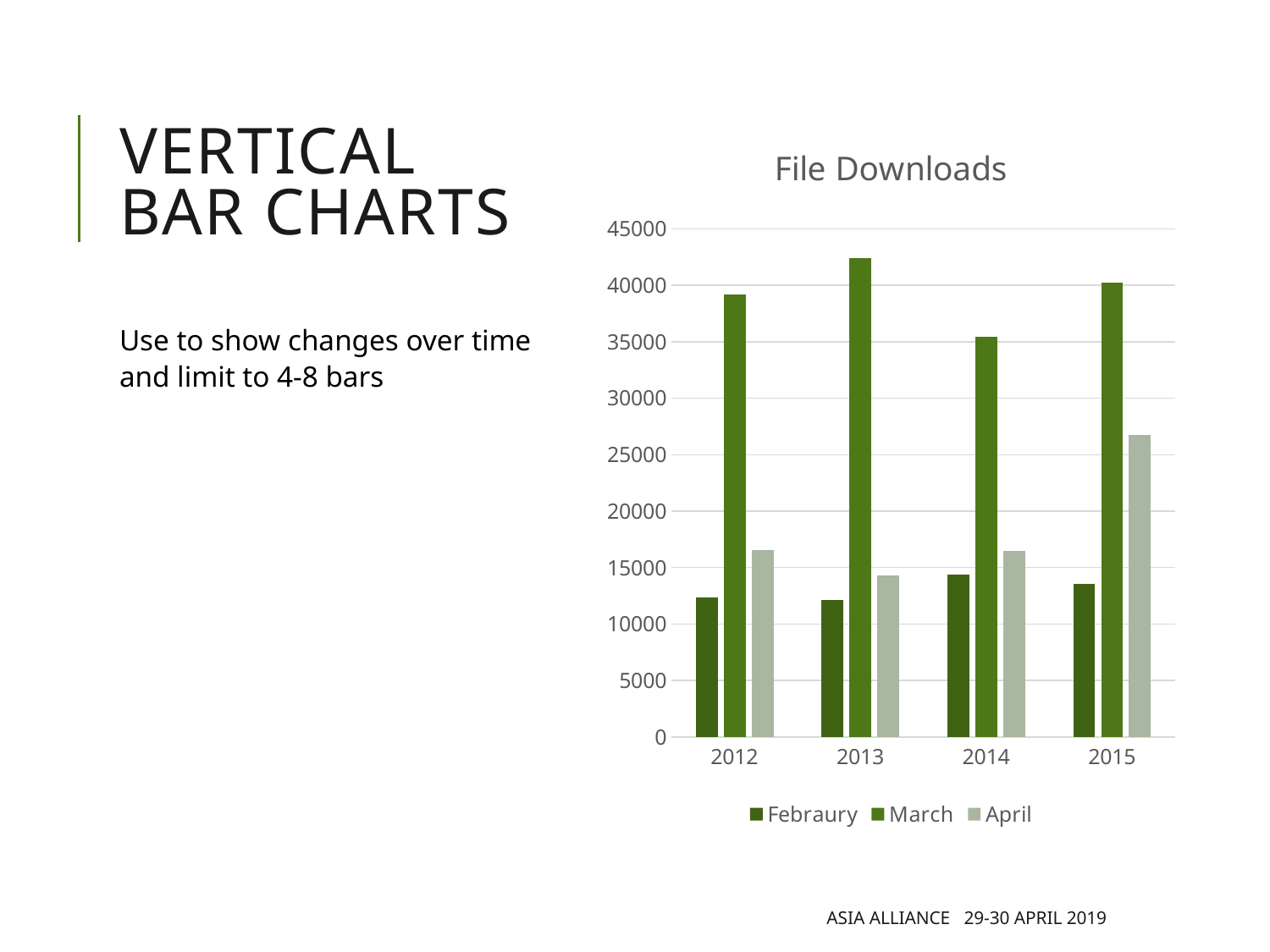
What kind of chart is shown on the slide? bar chart What is the title of the chart? File Downloads In which year is the April value highest? 2015 How many series does the legend list? 3 In which year is the March value lowest? 2014 Is the March value for 2013 greater or less than 40000? greater Is the April value for 2015 greater or less than 25000? greater Which series is shown in the lightest colour in the legend? April How many years are shown on the x axis? 4 Is the Febraury value for 2014 greater or less than 15000? less In which year is the March value highest? 2013 Which is larger, the April value for 2015 or the April value for 2012? April 2015